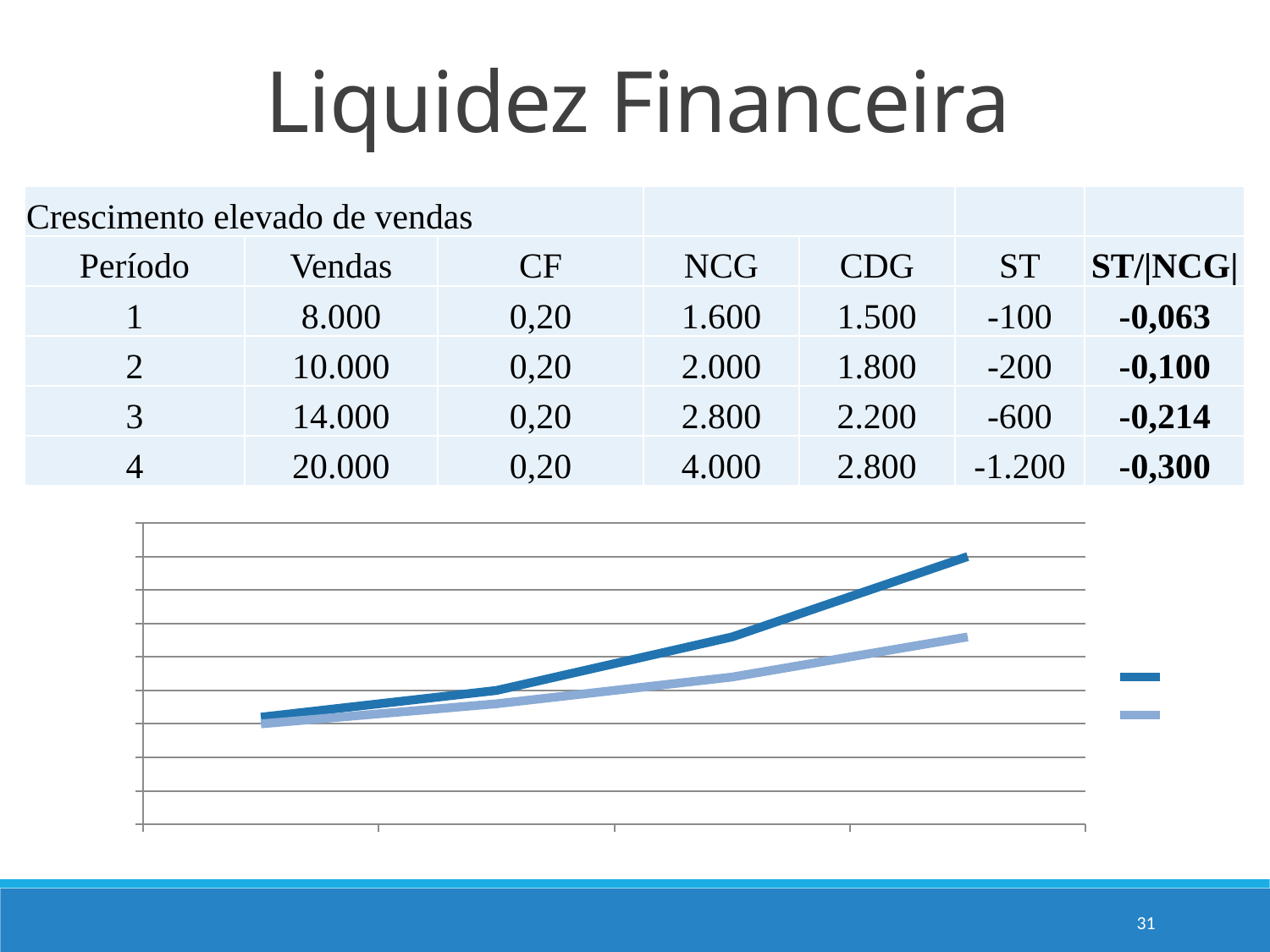
How many series does the legend of the chart list? 2 Do the values of the dark blue line rise or fall from left to right along the x axis? rise What kind of chart is shown on the slide? line chart Do the values of the light blue line rise or fall from left to right along the x axis? rise Does the gap between the two lines widen or narrow from left to right? widen At the rightmost point of the chart, which line is higher, the dark blue line or the light blue line? the dark blue line Which line in the chart reaches the highest value? the dark blue line Which line in the chart ends at the lowest value at the rightmost point? the light blue line How many data points does each line in the chart have? 4 What colours are the two lines in the chart? dark blue and light blue